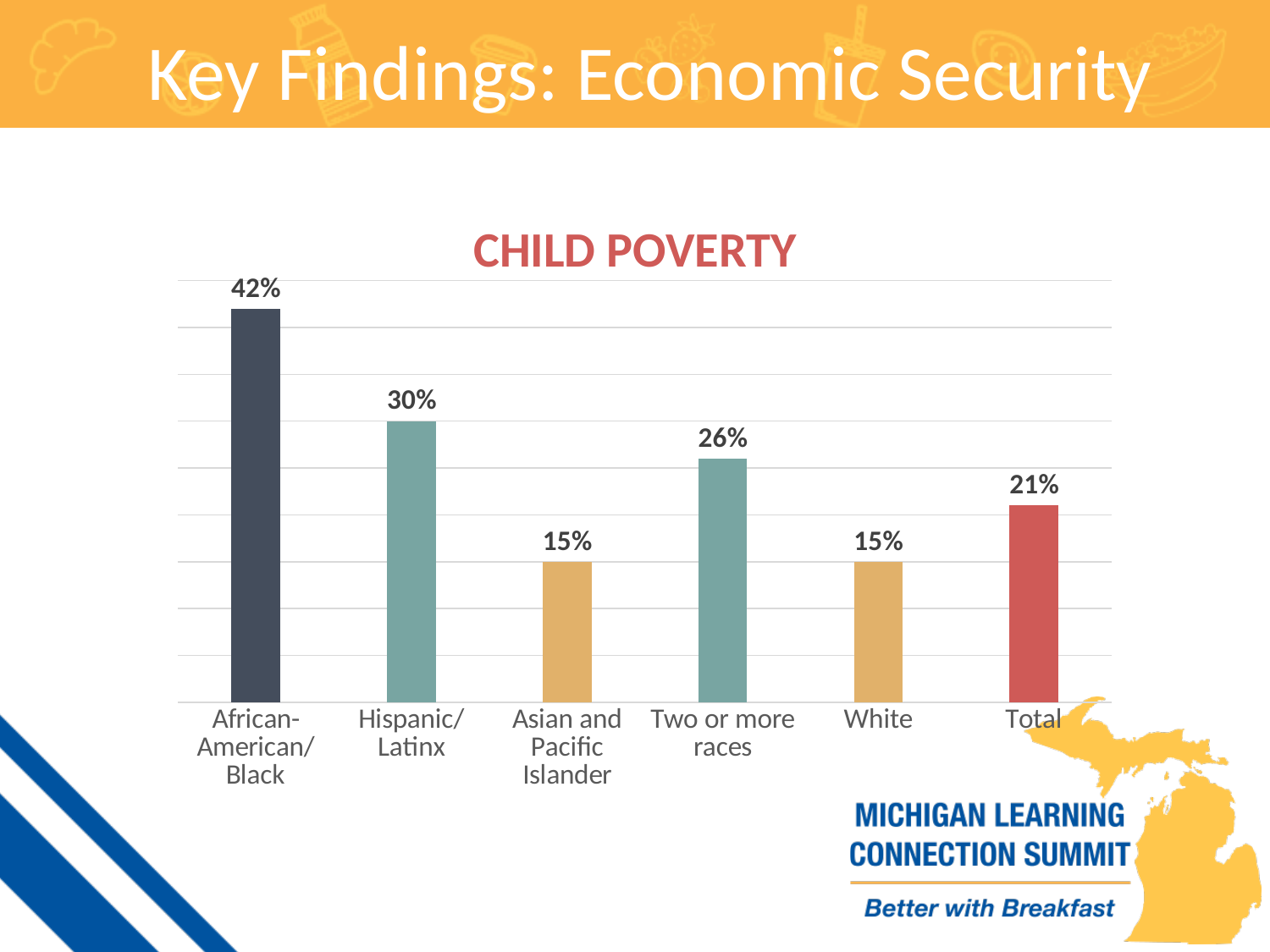
What is the difference between the child poverty rates for Hispanic/Latinx and White children? 15% What is the difference between the child poverty rate for African-American/Black children and the Total? 21% What is the child poverty rate for Two or more races? 26% What kind of chart is used to show child poverty? Bar chart How many categories are shown on the Child Poverty chart? 6 Which two categories share the same child poverty rate of 15%? Asian and Pacific Islander and White Which is larger, the child poverty rate for Two or more races or for Hispanic/Latinx? Hispanic/Latinx What is the child poverty rate for African-American/Black children? 42% Which category has the highest child poverty rate? African-American/Black What is the title of the chart? CHILD POVERTY What is the child poverty rate for Hispanic/Latinx children? 30% What is the Total child poverty rate shown on the chart? 21%